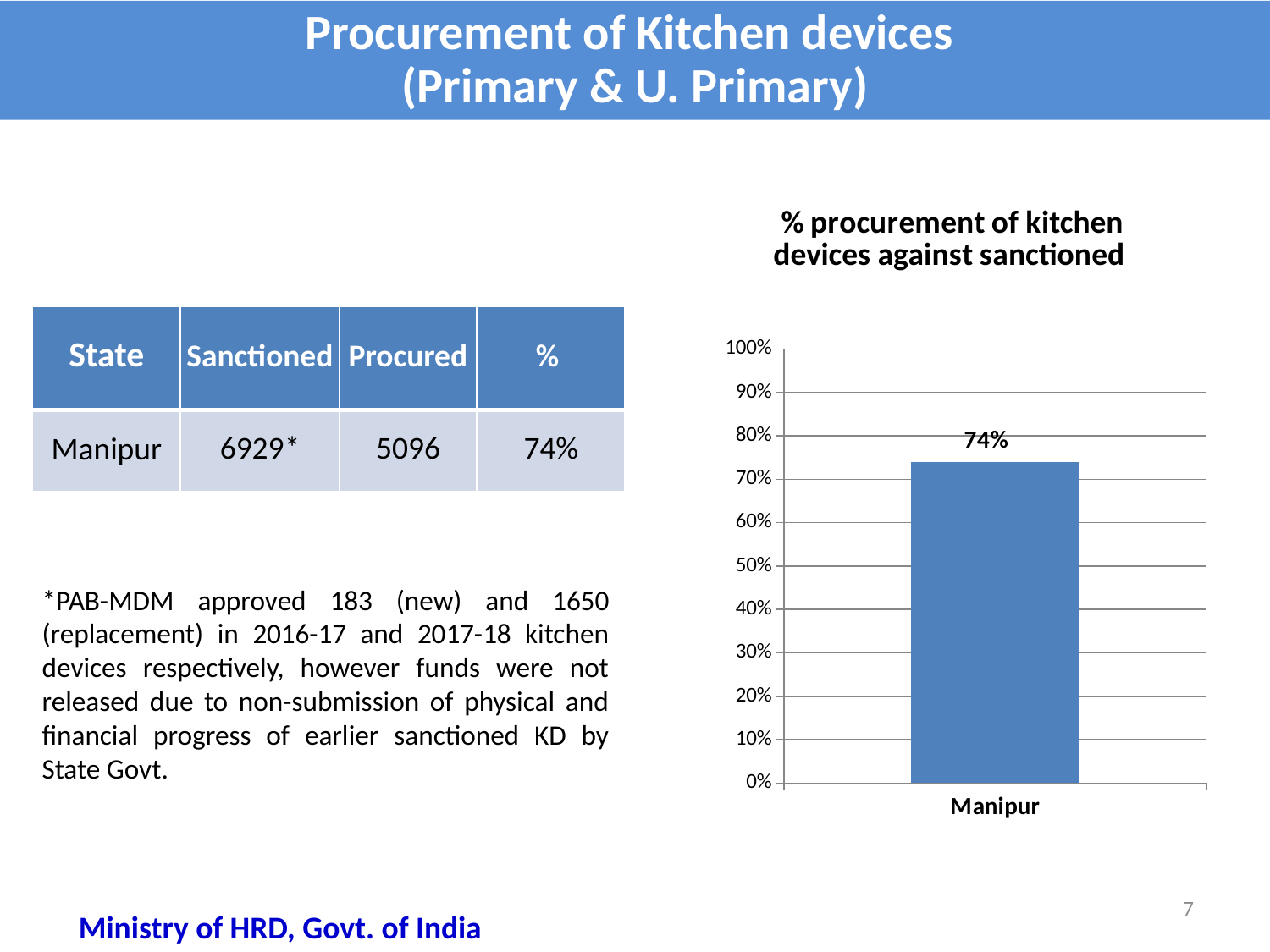
What kind of chart is shown on the slide? bar chart How many categories are plotted in the chart? 1 Is the value for Manipur greater or less than 50%? greater Which state is shown on the x axis of the chart? Manipur What is the value for Manipur in the chart? 74% What is the highest value shown on the chart's vertical axis? 100% Is the value for Manipur greater or less than 80%? less What is the title of the chart? % procurement of kitchen devices against sanctioned